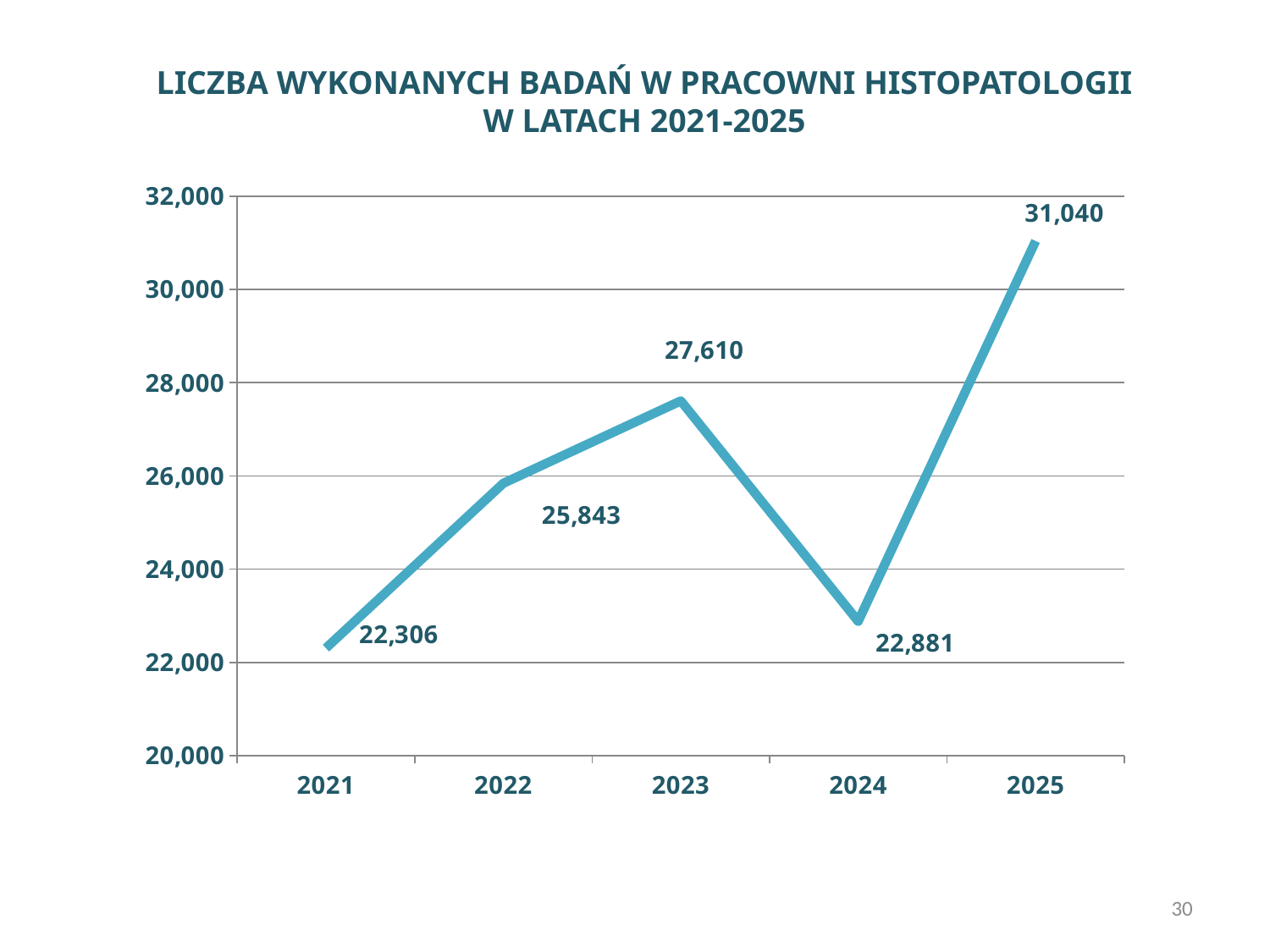
What is the value for 2023? 27,610 Which year has the lowest value? 2021 Which is larger, the value for 2022 or the value for 2024? 2022 Is the value for 2024 greater or less than 24,000? less Which year has the highest value? 2025 Does the value rise or fall from 2023 to 2024? fall What is the difference between the values for 2023 and 2022? 1,767 How many years are plotted on the chart? 5 What kind of chart is shown on the slide? line chart What is the value for 2025? 31,040 What is the difference between the values for 2025 and 2021? 8,734 What is the value for 2021? 22,306